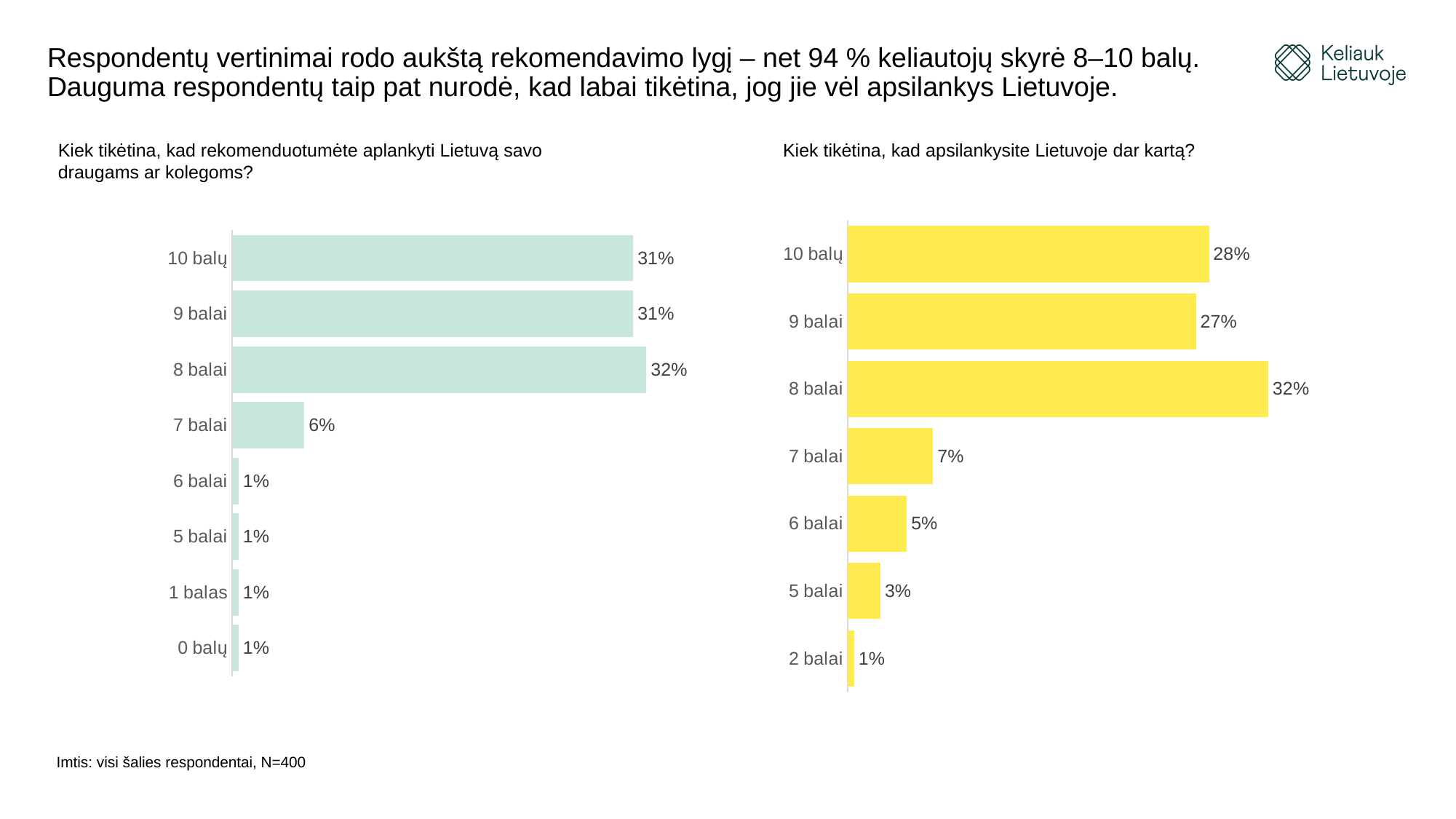
In the right chart (likelihood of visiting Lithuania again), what is the difference in percentage points between 8 balai and 9 balai? 5 In the right chart (likelihood of visiting Lithuania again), what percentage of respondents gave 10 balų? 28% In the left chart (recommending Lithuania to friends or colleagues), what percentage of respondents gave 8 balai? 32% In the left chart (recommending Lithuania to friends or colleagues), which score category has the highest percentage? 8 balai In the right chart (likelihood of visiting Lithuania again), what percentage of respondents gave 6 balai? 5% In the left chart (recommending Lithuania to friends or colleagues), what is the difference in percentage points between 8 balai and 7 balai? 26 What type of chart is used in the right chart (likelihood of visiting Lithuania again)? Bar chart In the right chart (likelihood of visiting Lithuania again), which score category has the lowest percentage? 2 balai In the right chart (likelihood of visiting Lithuania again), which is larger: the value for 7 balai or the value for 5 balai? 7 balai How many score categories are shown in the right chart (likelihood of visiting Lithuania again)? 7 How many score categories are shown in the left chart (recommending Lithuania to friends or colleagues)? 8 What colour are the bars in the right chart (likelihood of visiting Lithuania again)? Yellow